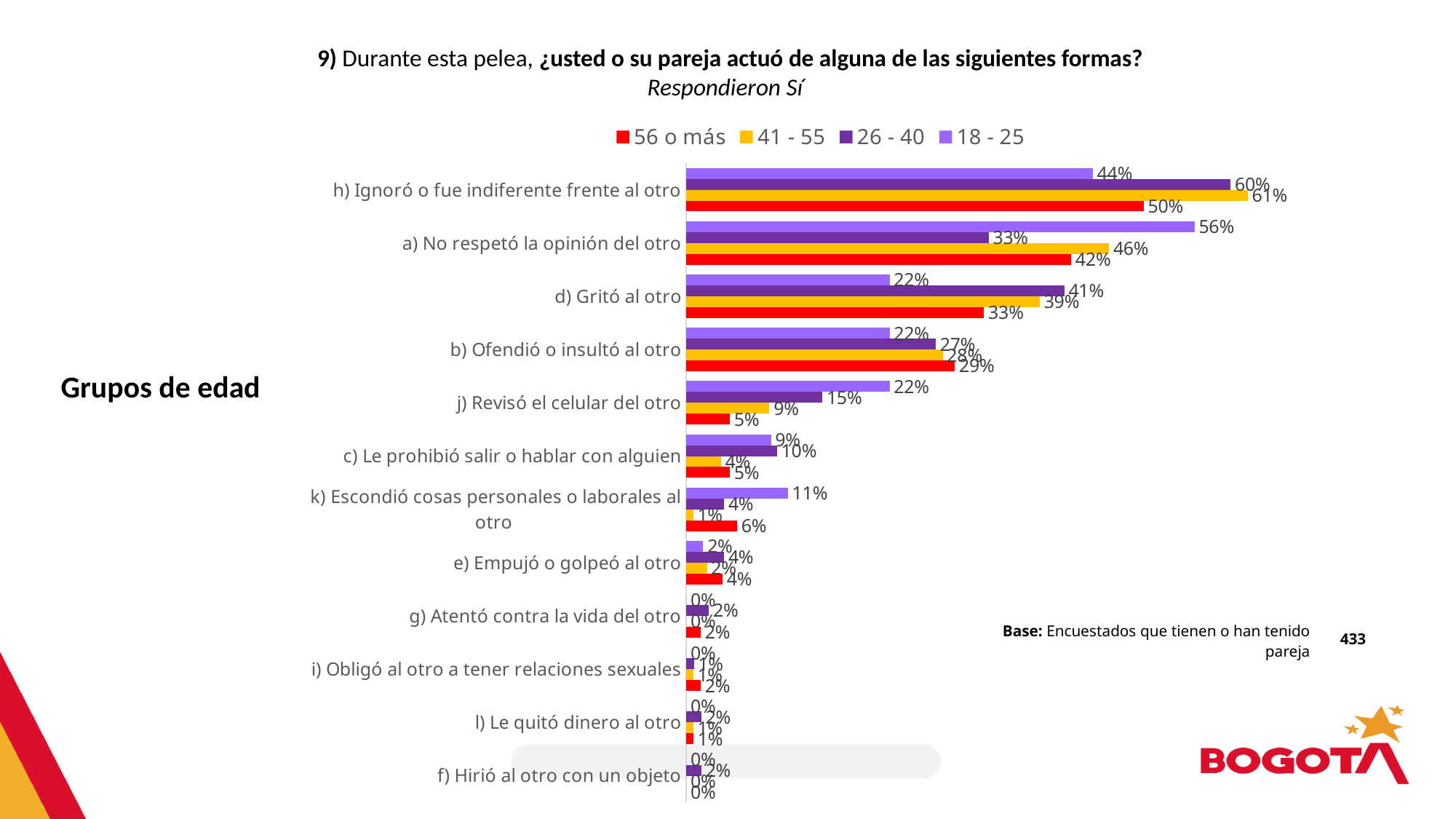
What is the value for the 56 o más group for 'd) Gritó al otro'? 33% What is the value for the 26 - 40 group for 'j) Revisó el celular del otro'? 15% What kind of chart is shown on the slide? bar chart What is the difference between the 26 - 40 and 18 - 25 values for 'h) Ignoró o fue indiferente frente al otro'? 16% Which age group has the lowest value for 'j) Revisó el celular del otro'? 56 o más How many behaviour categories are plotted on the chart? 12 Which colour represents the 56 o más group in the legend? red How many age groups does the legend list? 4 For 'd) Gritó al otro', which is larger: the 26 - 40 value or the 18 - 25 value? 26 - 40 Which age group has the highest value for 'a) No respetó la opinión del otro'? 18 - 25 What is the value for the 41 - 55 group for 'h) Ignoró o fue indiferente frente al otro'? 61% What is the value for the 18 - 25 group for 'a) No respetó la opinión del otro'? 56%